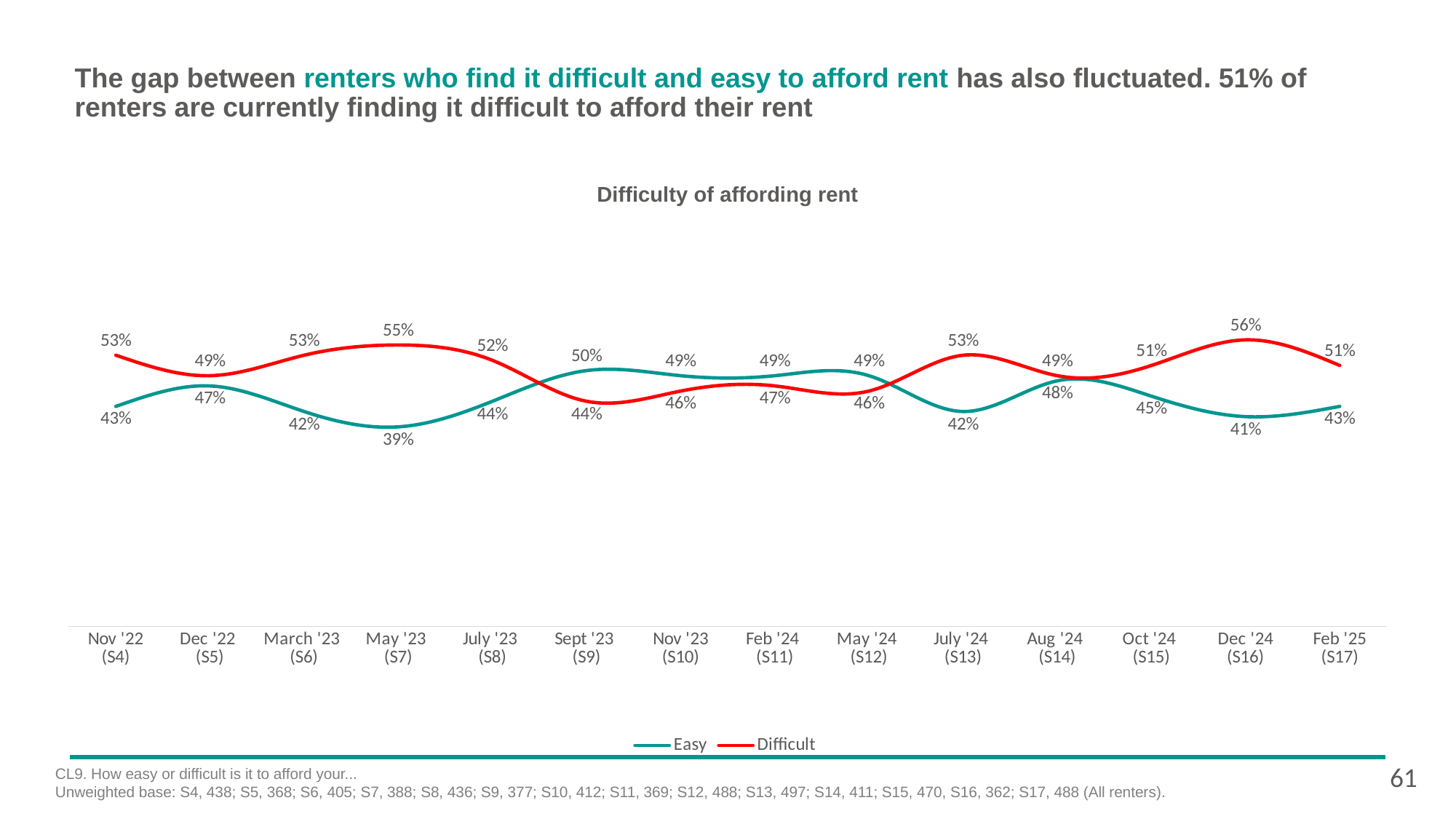
Which series has the larger value in Nov '23 (S10), Easy or Difficult? Easy In which period does the Easy series reach its lowest value? May '23 (S7) What is the value for Easy in May '23 (S7)? 39% What kind of chart is shown on the slide? Line chart What is the difference between the Difficult and Easy values in Dec '24 (S16)? 15 percentage points What is the title of the chart? Difficulty of affording rent In which period does the Easy series reach its highest value? Sept '23 (S9) How many time periods are shown on the x axis? 14 What is the value for Difficult in Feb '25 (S17)? 51% In which period does the Difficult series reach its highest value? Dec '24 (S16) What is the value for Difficult in Sept '23 (S9)? 44% How many series does the legend list? 2